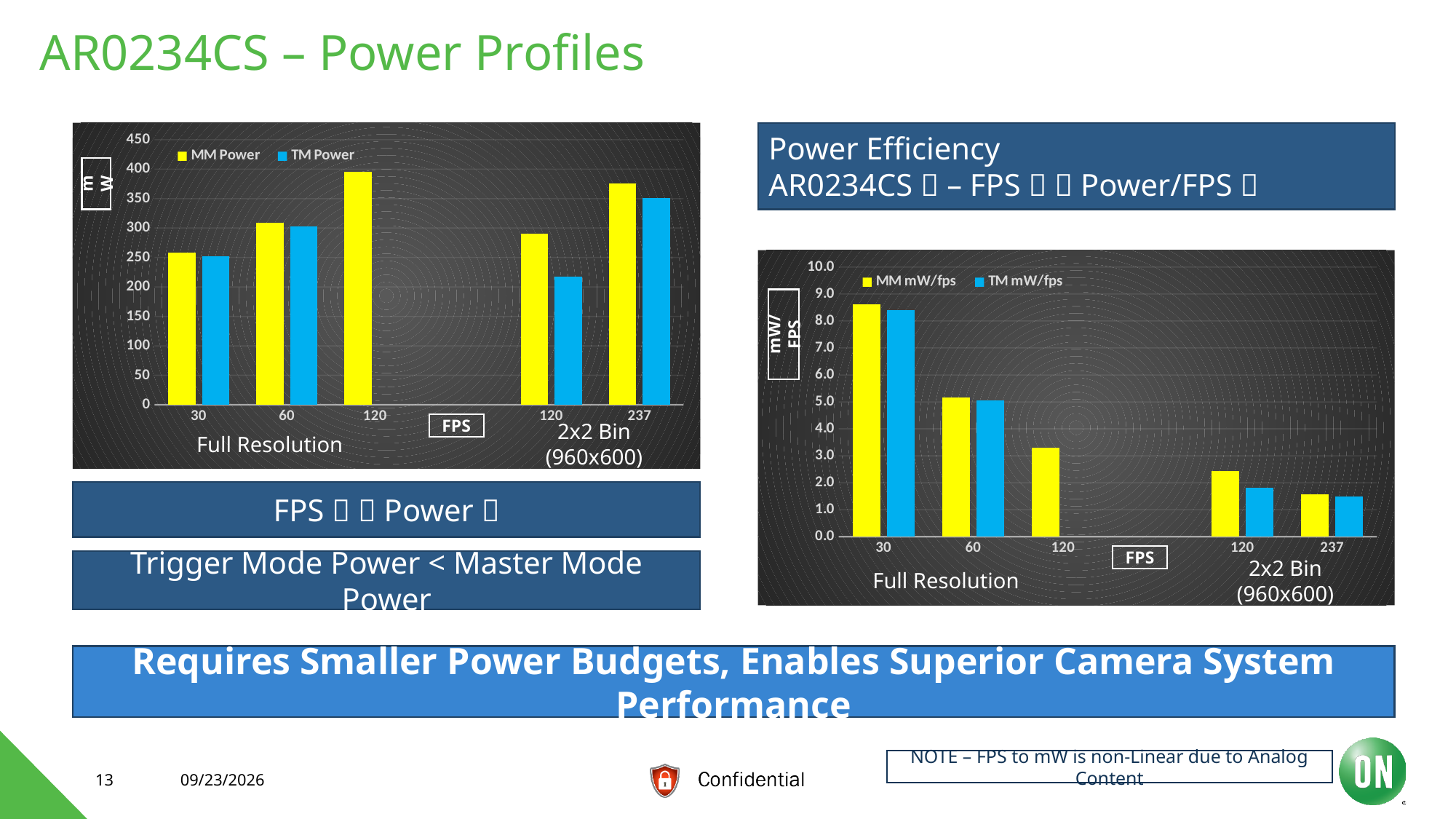
What colour are the TM mW/fps bars in the right chart? blue How many series does the legend of the left chart list? 2 In the right chart, is the TM mW/fps value at 120 FPS (2x2 Bin) greater or less than 2.0? less In the right chart (mW/FPS), which FPS category has the highest MM mW/fps bar? 30 In the left chart, at 120 FPS in 2x2 Bin mode, which is larger: MM Power or TM Power? MM Power In the left chart, which FPS category has the highest MM Power bar? 120 (Full Resolution) What kind of chart is the left chart (mW vs FPS)? bar chart In the right chart, does MM mW/fps rise or fall as FPS increases from 30 to 120 in Full Resolution? fall In the left chart, does MM Power rise or fall as FPS increases from 30 to 120 in Full Resolution? rise In the left chart, is the MM Power value at 120 FPS (Full Resolution) greater or less than 350? greater In the right chart, is the MM mW/fps value at 30 FPS greater or less than 8.0? greater